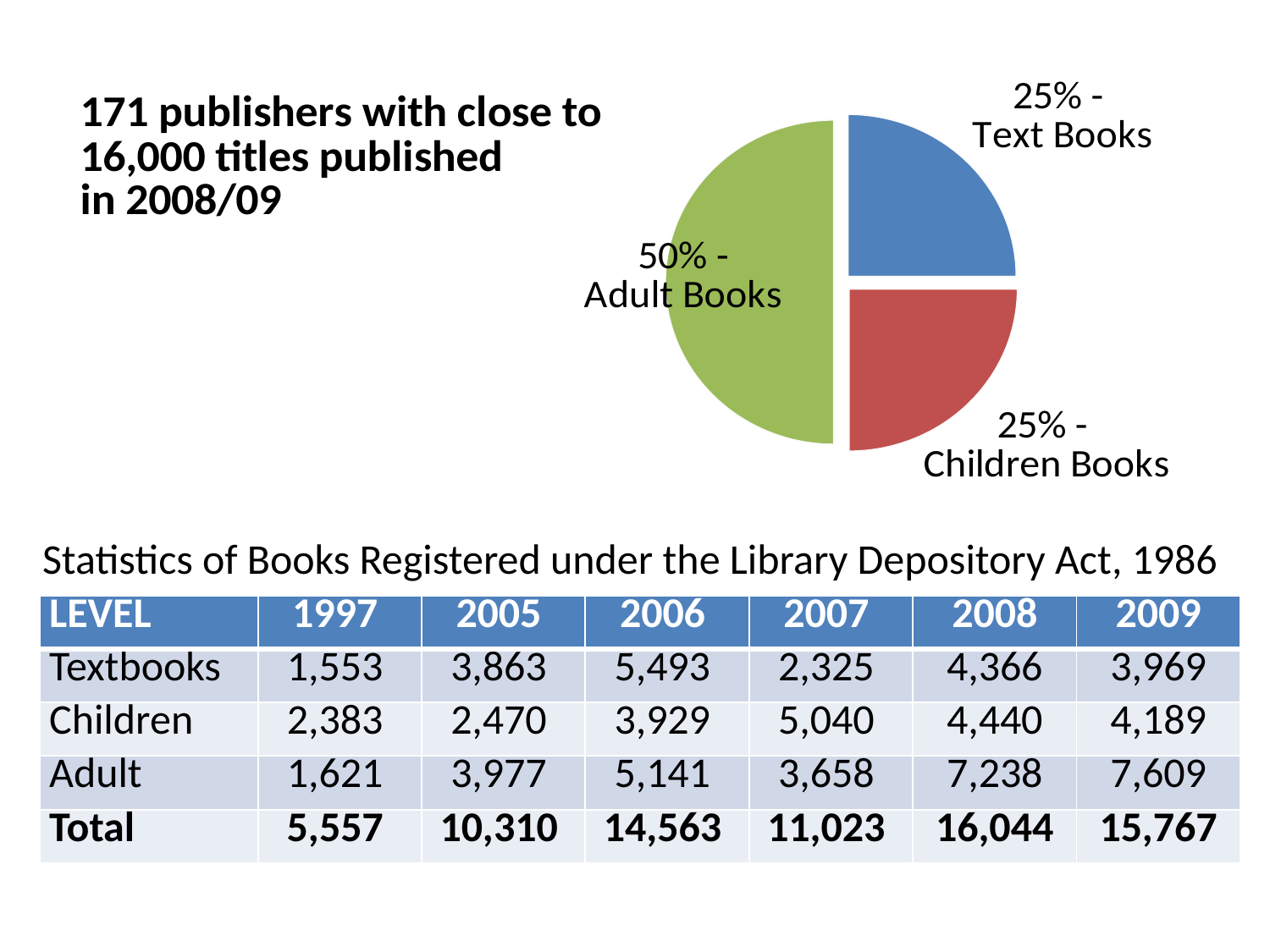
What colour is the Adult Books slice in the pie chart? green What is the difference in percentage points between the Adult Books slice and the Children Books slice? 25% What share of the pie chart is Text Books? 25% What share of the pie chart is Adult Books? 50% What kind of chart is shown on the slide? pie chart What share of the pie chart is Children Books? 25% Which is larger in the pie chart, Adult Books or Text Books? Adult Books What colour is the Text Books slice in the pie chart? blue Which category has the largest slice in the pie chart? Adult Books How many slices does the pie chart have? 3